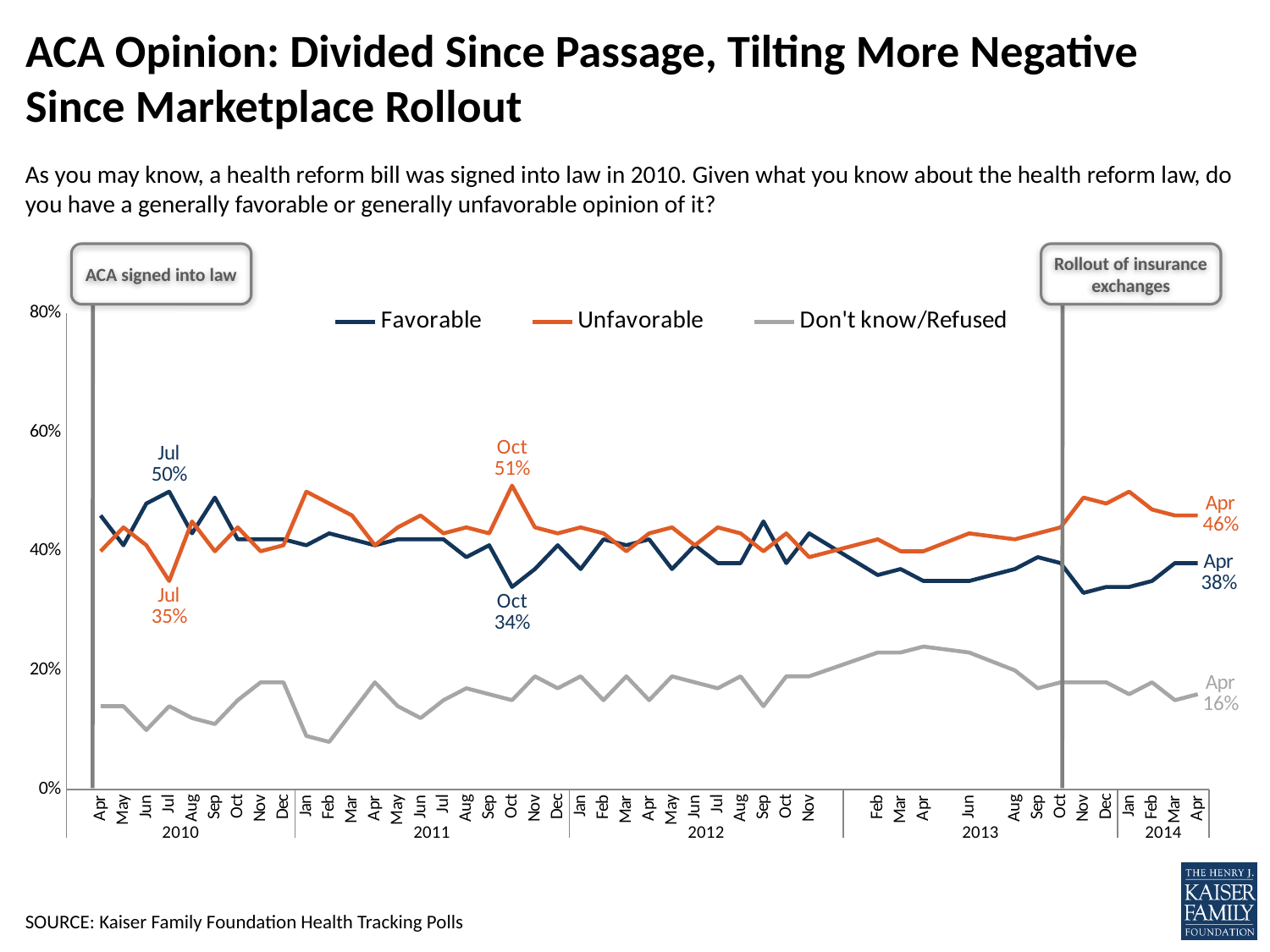
What kind of chart is shown on the slide? line chart What is the difference between the Unfavorable and Favorable values in April 2014? 8 percentage points Is the Don't know/Refused value in April 2013 greater or less than 20%? greater What was the Unfavorable value in July 2010? 35% What is the difference between the Favorable and Unfavorable values in July 2010? 15 percentage points In April 2014, which is larger: the Favorable value or the Unfavorable value? Unfavorable What was the Unfavorable value in October 2011? 51% Which series is shown in orange in the legend? Unfavorable What was the Favorable value in October 2011? 34% What was the Favorable value in July 2010? 50% What was the Don't know/Refused value in April 2014? 16% How many series does the legend list? 3